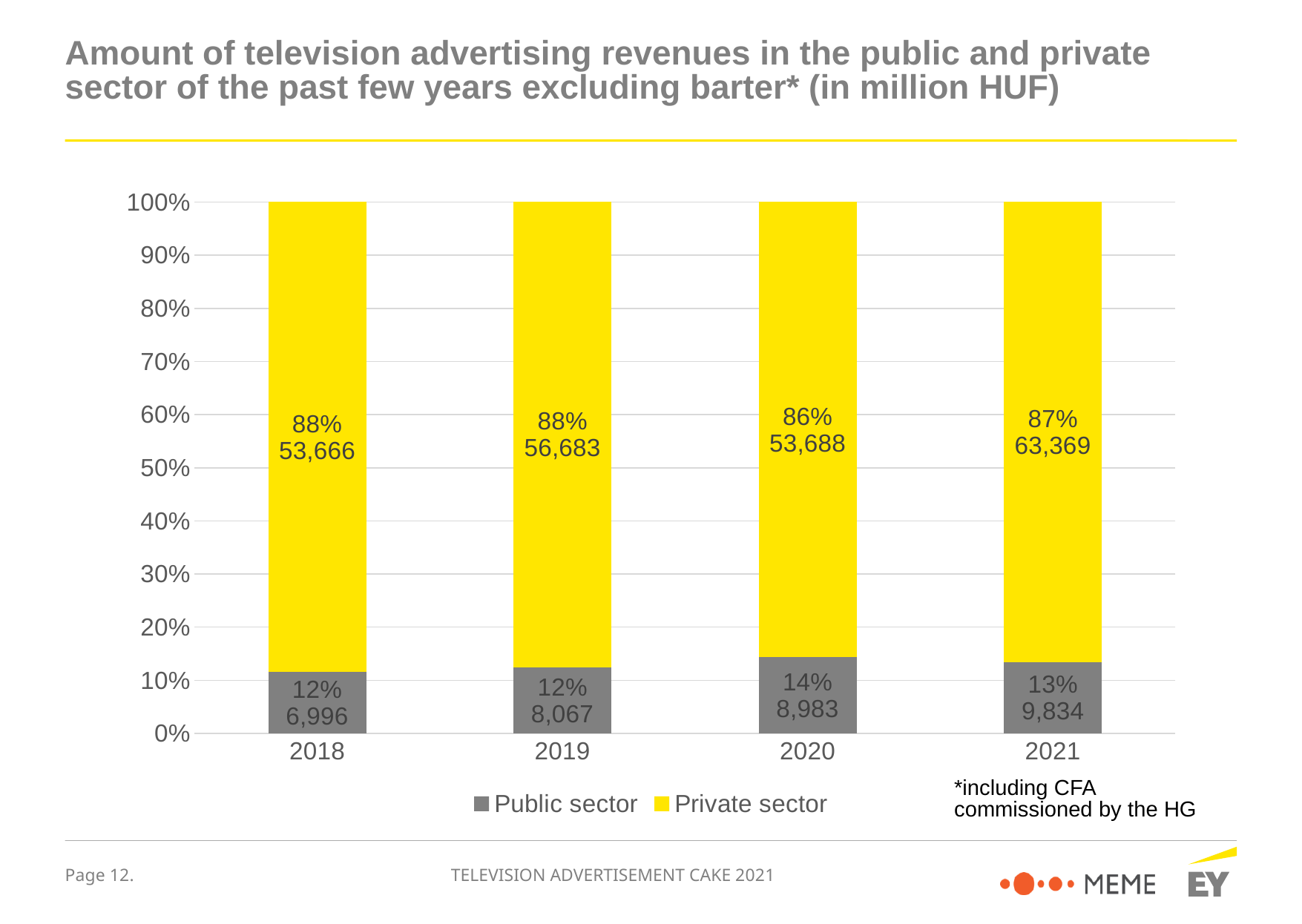
In which year is the public sector revenue the lowest? 2018 What is the private sector television advertising revenue for 2021? 63,369 What is the total of the public and private sector revenues in 2018? 60,662 In which year is the private sector revenue the highest? 2021 How many years are shown on the x axis? 4 What is the public sector television advertising revenue for 2018? 6,996 How many series does the legend list? 2 What percentage share does the public sector have in 2020? 14% Which is larger, the private sector revenue in 2019 or in 2020? 2019 What kind of chart is shown on the slide? Stacked bar chart Do the public sector revenue values rise or fall from 2018 to 2021? Rise What is the difference between the public sector revenue in 2021 and in 2020? 851